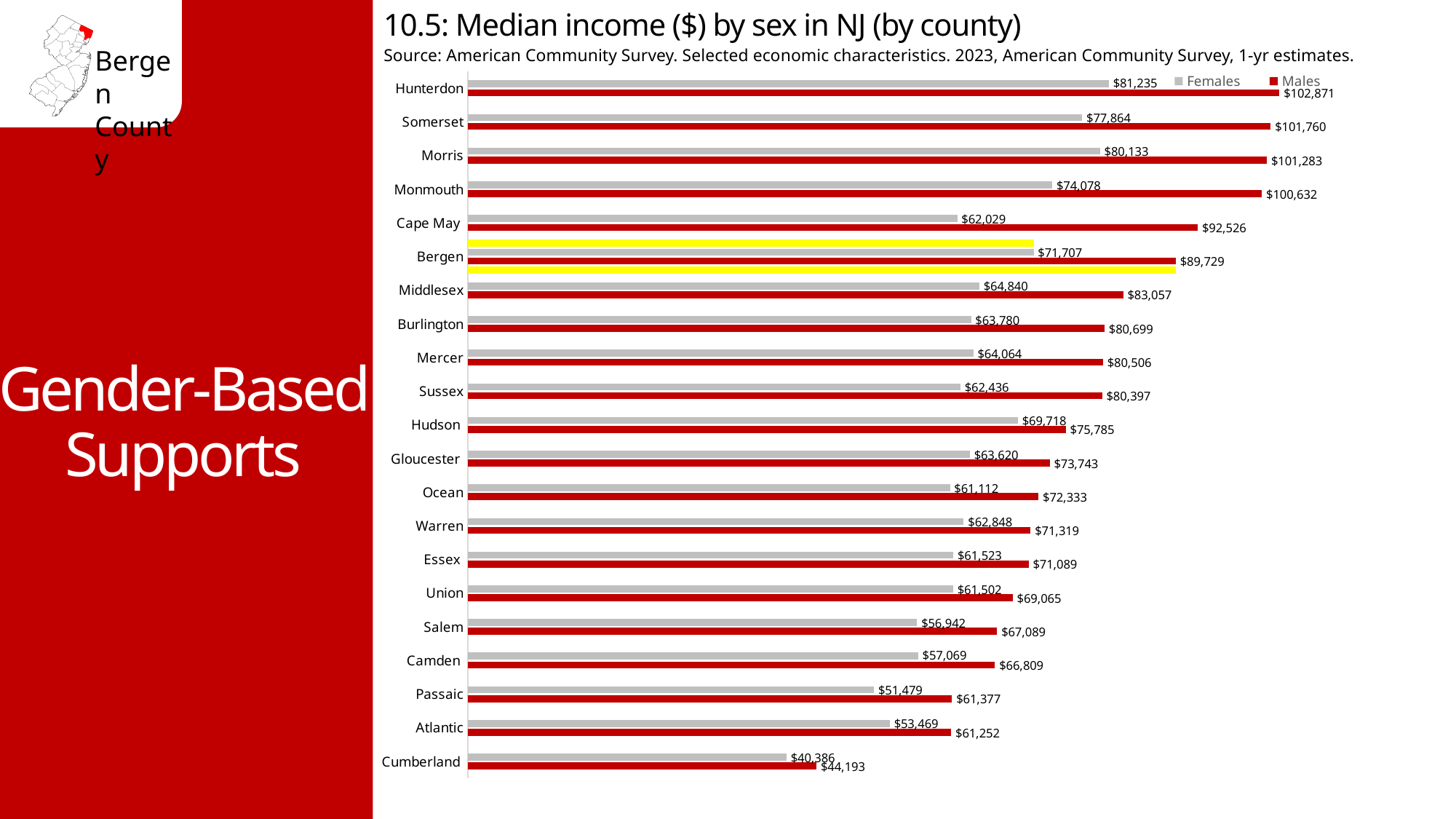
What is the difference between the male and female median incomes in Cumberland County? $3,807 Which county has the lowest median income for females? Cumberland Which county has the highest median income for males? Hunterdon What is the median income for females in Cumberland County? $40,386 What is the median income for males in Bergen County? $89,729 What kind of chart is shown on the slide? Bar chart What is the median income for females in Hunterdon County? $81,235 How many counties are shown in the chart? 21 How many series does the legend list? 2 Which colour represents the Males series in the chart? Red What is the difference between the male and female median incomes in Bergen County? $18,022 Which is larger, the female median income in Hudson County or the female median income in Middlesex County? Hudson County